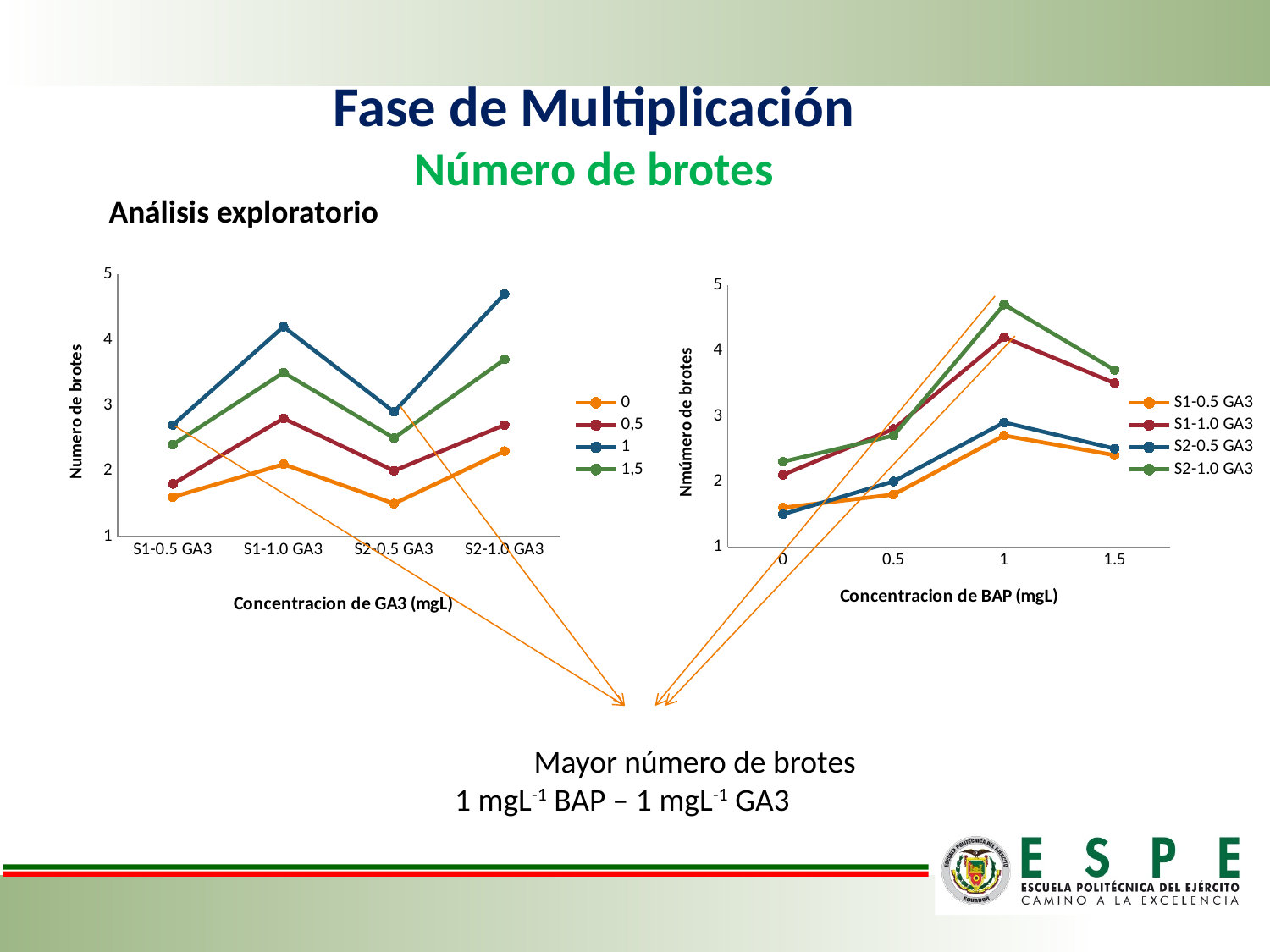
In the right chart, is the value for S2-1.0 GA3 at BAP concentration 1 greater or less than 4? greater In the left chart, is the value for series 0 at S1-0.5 GA3 greater or less than 2? less In the left chart, which category has the lowest value for series 0? S2-0.5 GA3 What is the x-axis title of the right chart? Concentracion de BAP (mgL) In the right chart, at which BAP concentration does the S2-1.0 GA3 series reach its highest value? 1 In the left chart, is the value for series 1 at S1-1.0 GA3 greater or less than 4? greater How many categories are on the x axis of the left chart? 4 What kind of chart is the left chart on the slide? line chart How many series does the legend of the right chart list? 4 In the left chart, which series has the larger value at S2-0.5 GA3, series 1 or series 0? 1 How many series does the legend of the left chart list? 4 In the left chart, which category has the highest value for series 1? S2-1.0 GA3